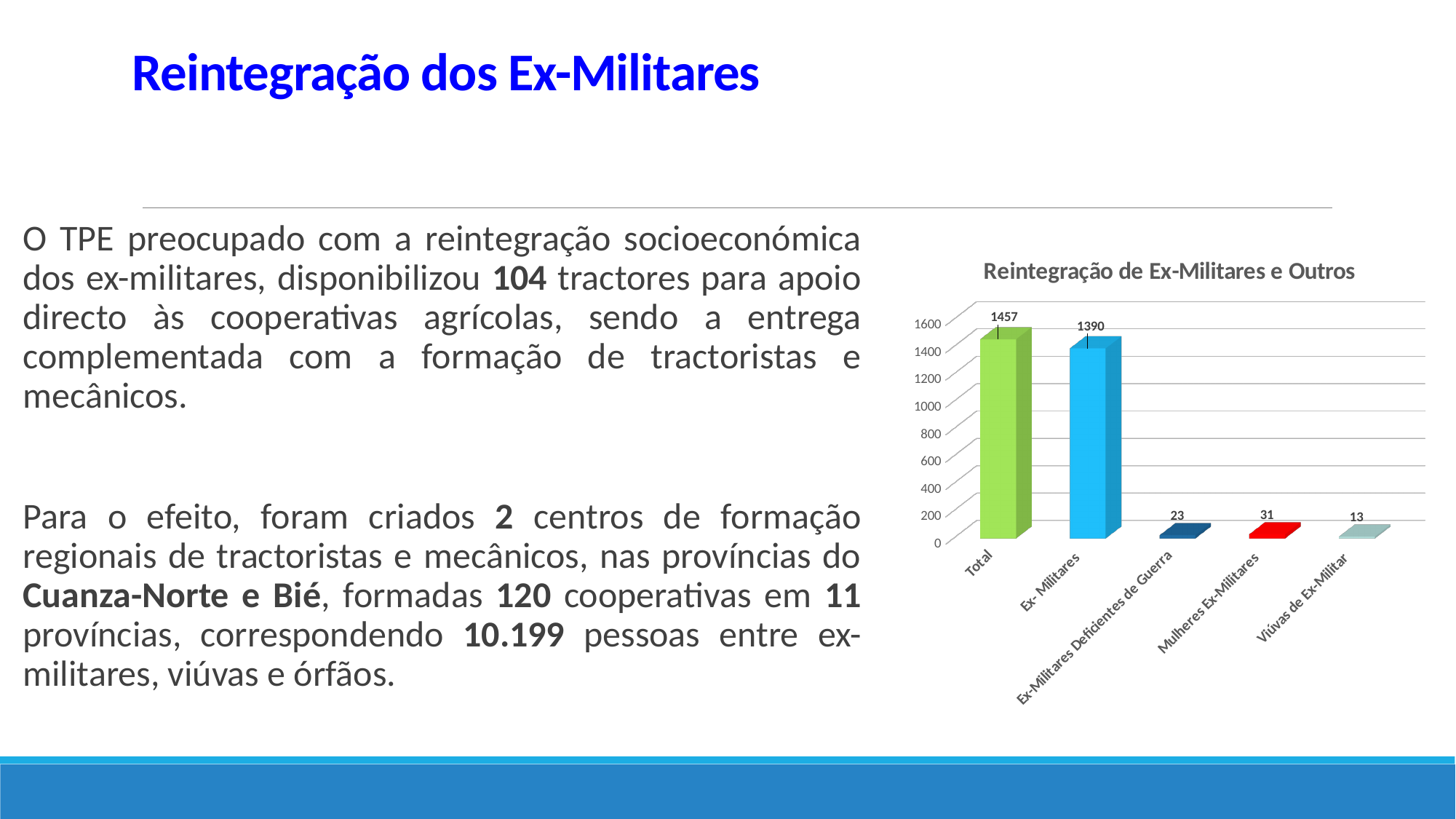
What is the difference between the values for Total and Ex- Militares? 67 What is the value for Viúvas de Ex-Militar? 13 What is the value for Total in the chart? 1457 What is the value for Mulheres Ex-Militares? 31 What is the value for Ex- Militares in the chart? 1390 What is the value for Ex-Militares Deficientes de Guerra? 23 Which category has the lowest value in the chart? Viúvas de Ex-Militar What kind of chart is shown on the slide? Bar chart Which category has the highest value in the chart? Total What is the title of the chart? Reintegração de Ex-Militares e Outros How many categories are shown in the chart? 5 Which is larger, the value for Mulheres Ex-Militares or the value for Ex-Militares Deficientes de Guerra? Mulheres Ex-Militares